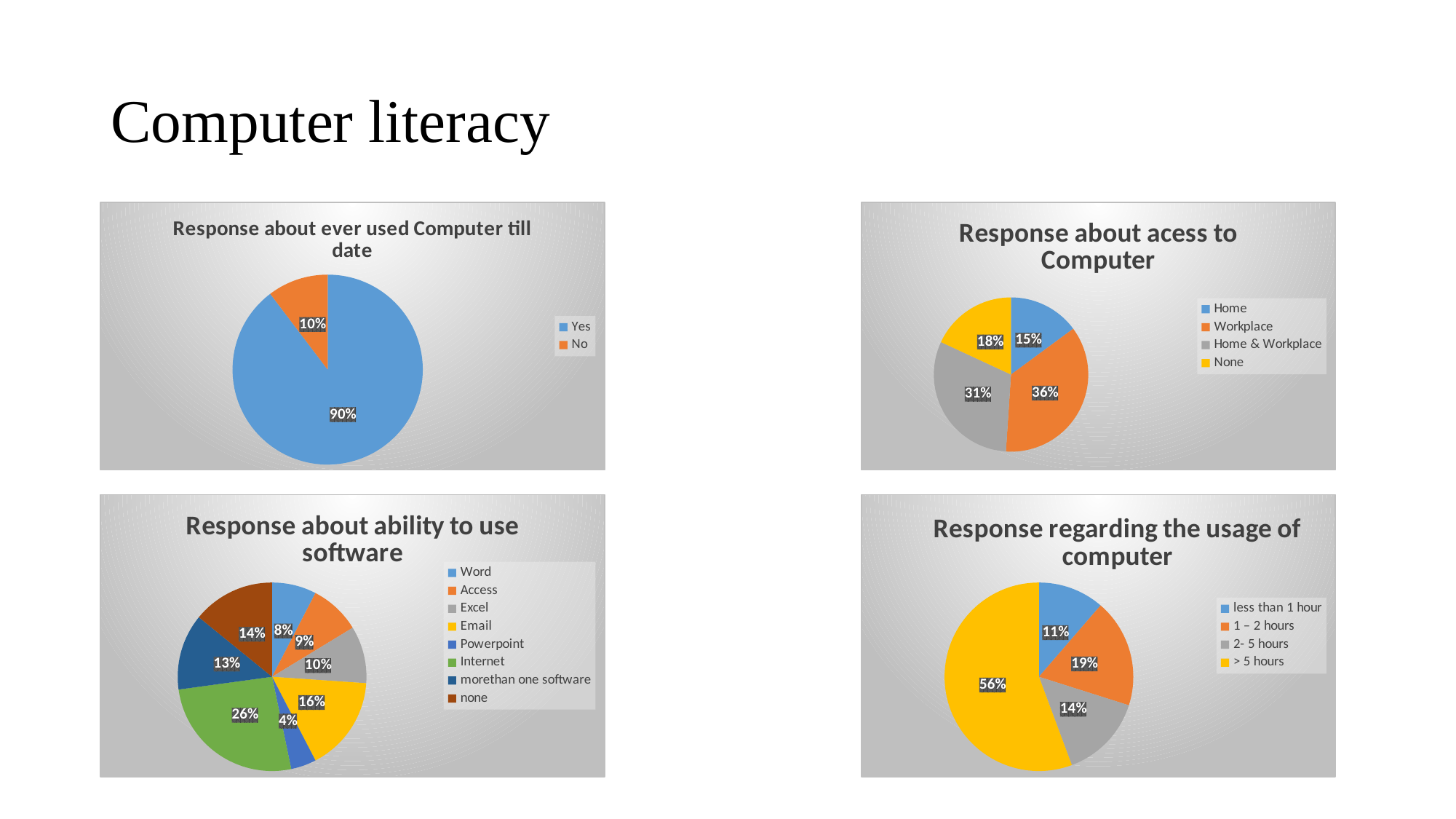
In the 'Response about ever used Computer till date' chart, what share of responses is 'Yes'? 90% In the 'Response regarding the usage of computer' chart, what is the difference between '1 – 2 hours' and 'less than 1 hour'? 8% In the 'Response about acess to Computer' chart, what is the value for 'Workplace'? 36% In the 'Response about ability to use software' chart, how many categories does the legend list? 8 In the 'Response regarding the usage of computer' chart, what is the value for '> 5 hours'? 56% What type of chart is the 'Response regarding the usage of computer' chart? Pie chart In the 'Response about ability to use software' chart, which category has the smallest share? Powerpoint In the 'Response about acess to Computer' chart, what is the difference between 'Home & Workplace' and 'None'? 13% In the 'Response about acess to Computer' chart, which category has the smallest share? Home In the 'Response about ability to use software' chart, what is the value for 'Internet'? 26% In the 'Response about ever used Computer till date' chart, what share of responses is 'No'? 10% In the 'Response about ability to use software' chart, which is larger, 'Email' or 'Excel'? Email